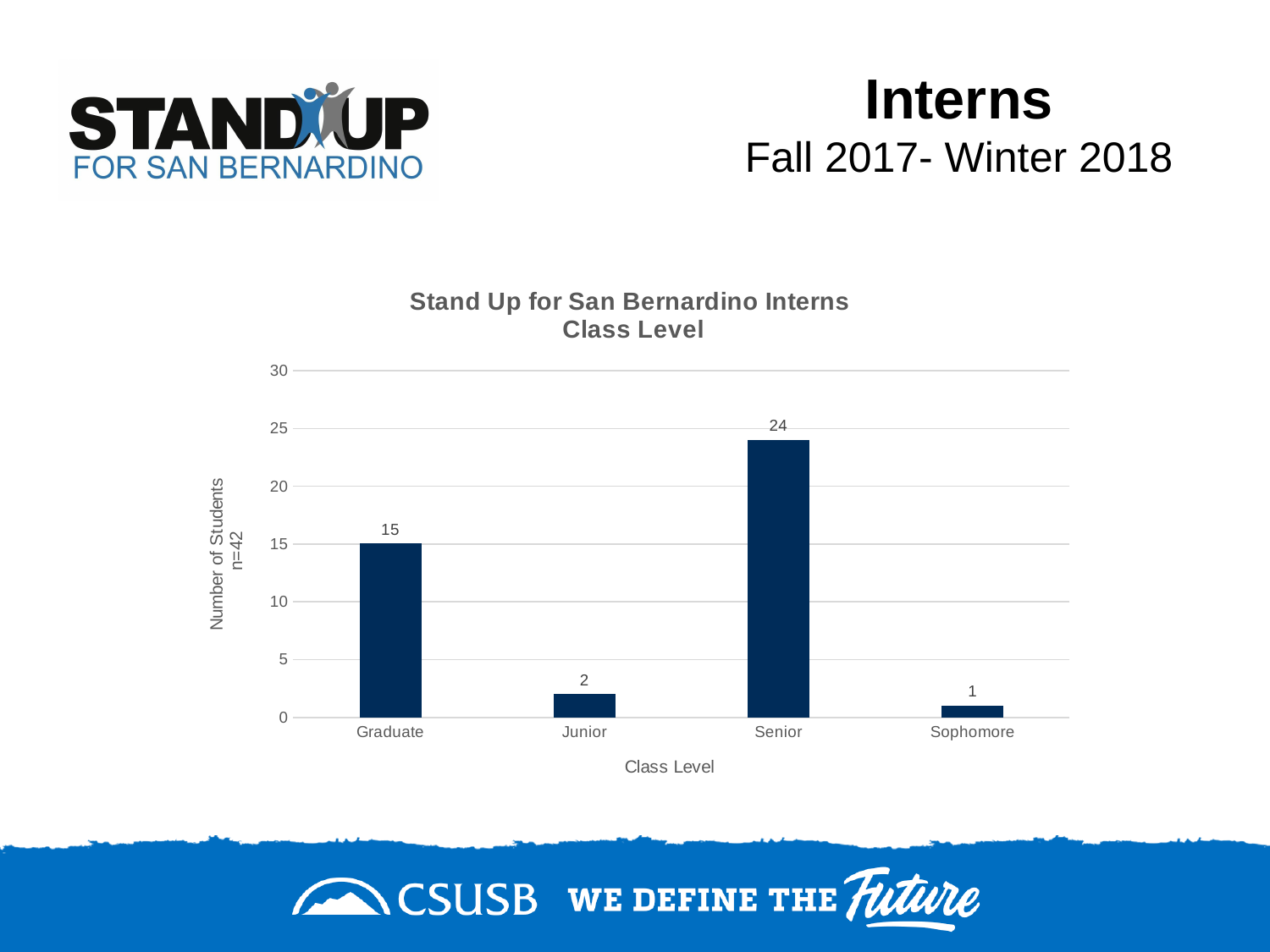
Which class level has the lowest number of students? Sophomore How many class levels are shown on the x axis? 4 Which class level has the highest number of students? Senior Which has more students, Junior or Sophomore? Junior What is the difference between the number of Senior and Graduate interns? 9 What kind of chart is shown on the slide? Bar chart How many Junior interns are shown? 2 Is the value for Senior greater or less than 20? greater What is the value for Sophomore? 1 What is the number of Senior interns? 24 How many students are Graduate interns? 15 What is the title of the chart? Stand Up for San Bernardino Interns Class Level